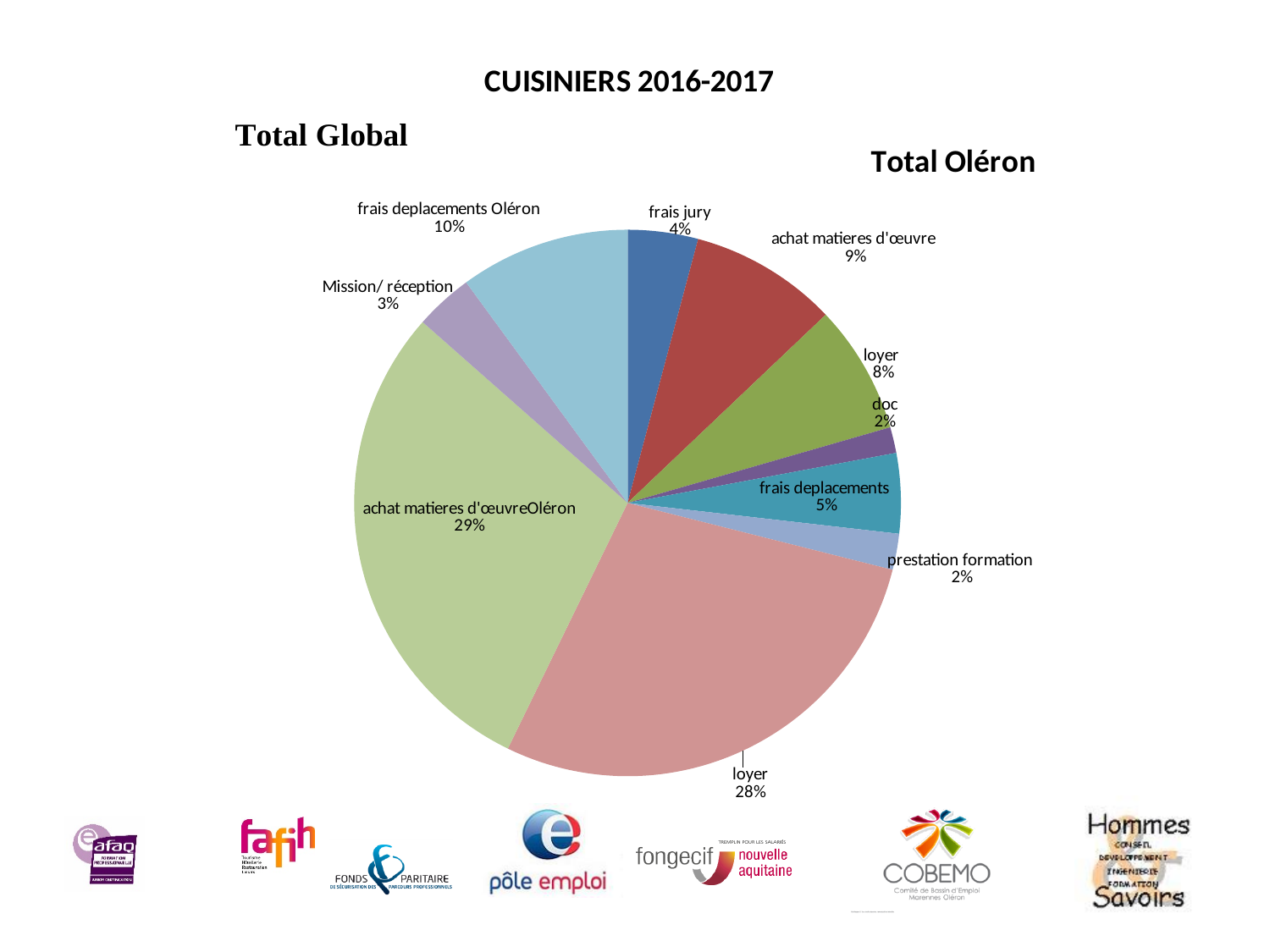
What share of the pie is 'achat matieres d'œuvreOléron'? 29% What percentage is shown for 'doc'? 2% How many slices does the pie chart have? 10 Which is larger: 'frais deplacements' or 'frais deplacements Oléron'? frais deplacements Oléron What percentage is shown for 'Mission/ réception'? 3% What is the difference in percentage points between the larger 'loyer' slice (28%) and 'achat matieres d'œuvre' (9%)? 19 Which slice has the largest share of the pie? achat matieres d'œuvreOléron What share of the pie is 'frais deplacements Oléron'? 10% What kind of chart is shown on the slide? pie chart What percentage is shown for 'frais jury'? 4% What is the combined share of 'doc' and 'prestation formation'? 4%